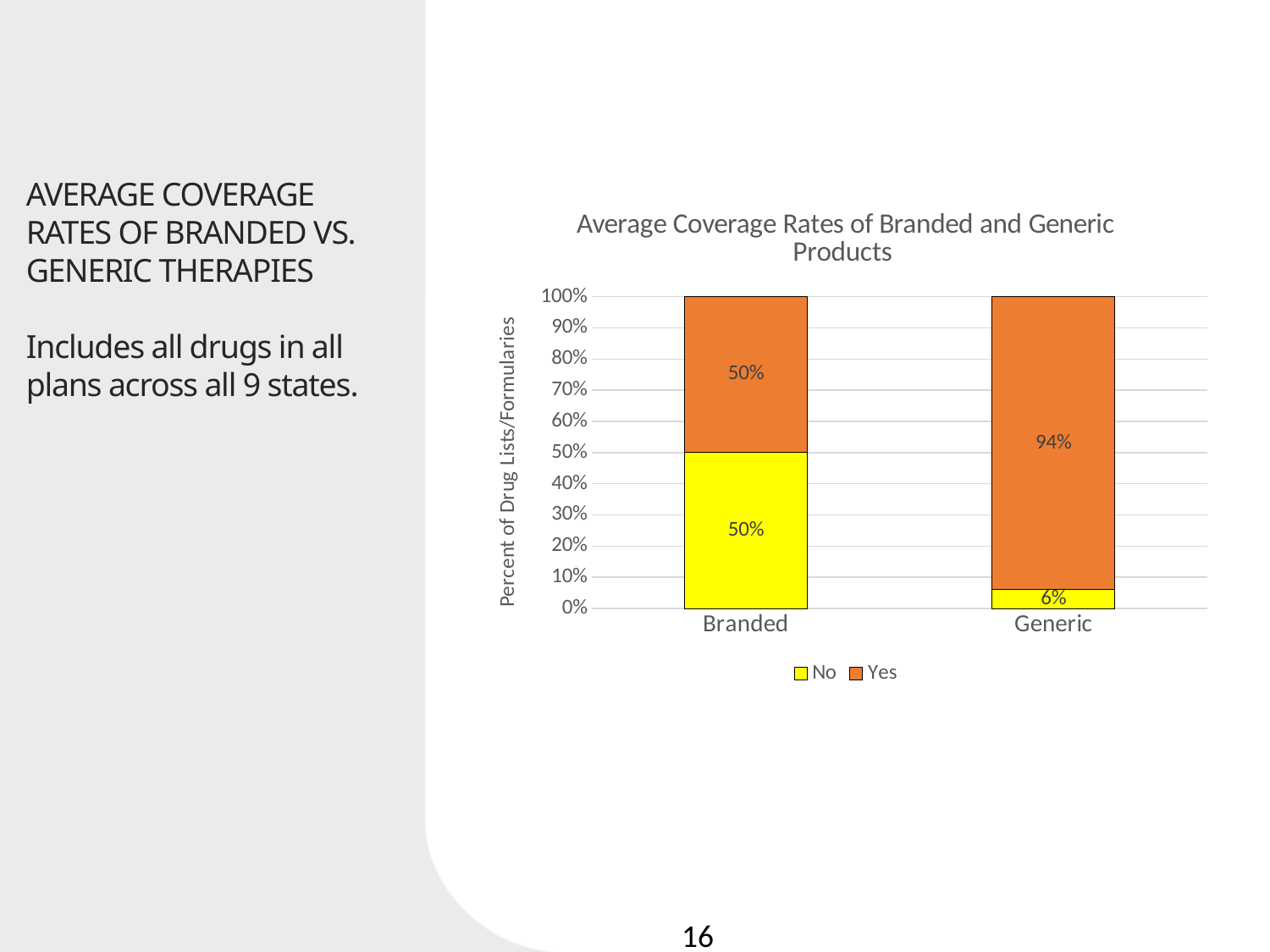
What is the 'No' value for Branded? 50% How many series does the legend list? 2 What is the 'Yes' value for Branded? 50% What is the difference between the 'Yes' values for Generic and Branded? 44% What is the title of the chart? Average Coverage Rates of Branded and Generic Products What is the 'No' value for Generic? 6% Which category has the lowest 'No' value? Generic What is the total of the stacked bar for Generic? 100% Which category has the higher 'Yes' value, Branded or Generic? Generic How many categories are shown on the x axis? 2 What is the 'Yes' value for Generic? 94% What kind of chart is shown? Stacked bar chart